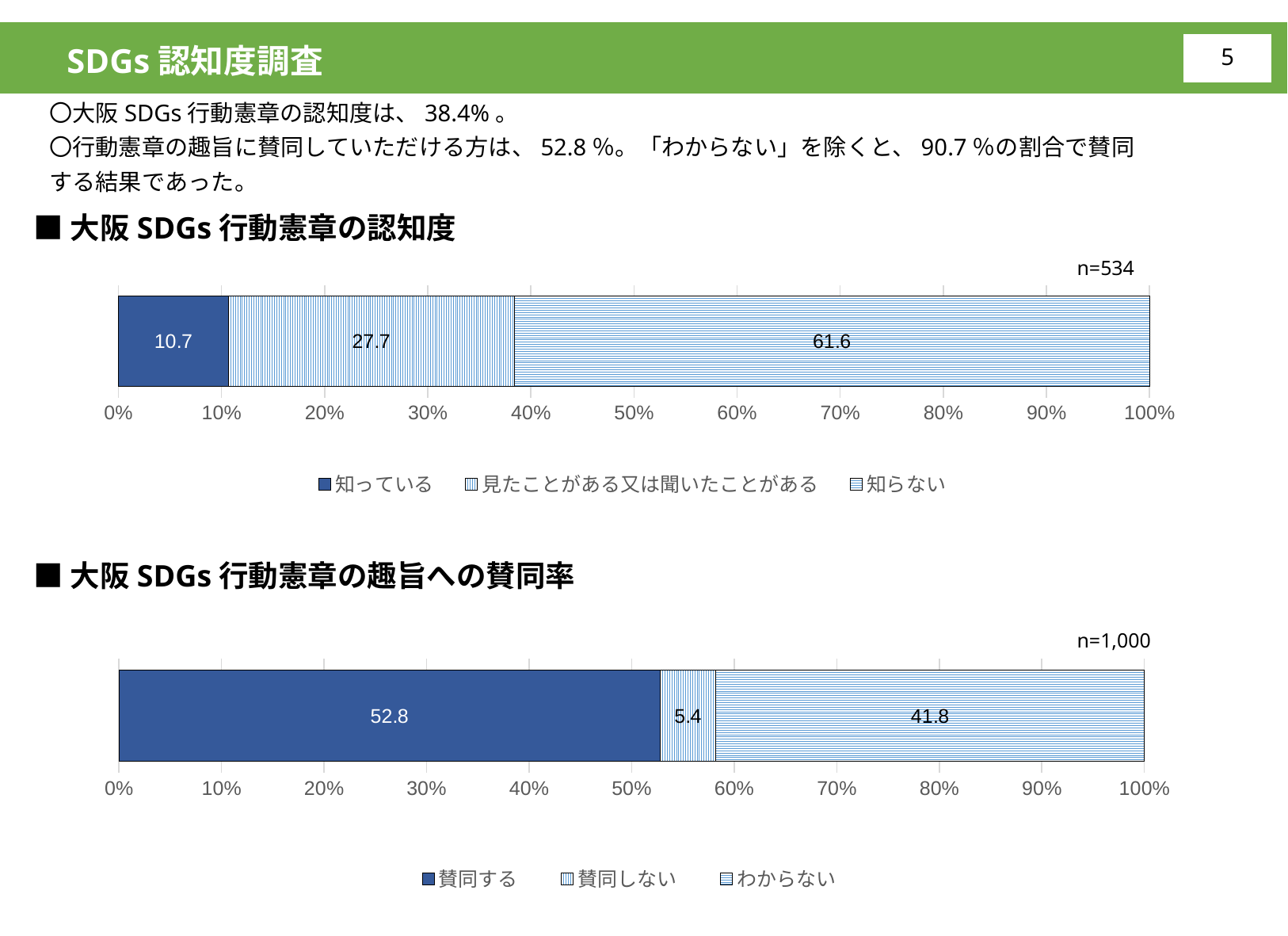
In the 大阪SDGs行動憲章の認知度 chart, what is the value for 知っている? 10.7 In the 大阪SDGs行動憲章の認知度 chart, what is the value for 知らない? 61.6 In the 大阪SDGs行動憲章の認知度 chart, which segment is the smallest? 知っている In the 大阪SDGs行動憲章の認知度 chart, how many series does the legend list? 3 What kind of chart is the 大阪SDGs行動憲章の趣旨への賛同率 chart? Stacked bar chart In the 大阪SDGs行動憲章の趣旨への賛同率 chart, what is the difference between 賛同する and わからない? 11.0 In the 大阪SDGs行動憲章の趣旨への賛同率 chart, what is the value for 賛同する? 52.8 In the 大阪SDGs行動憲章の趣旨への賛同率 chart, which is larger, 賛同する or わからない? 賛同する In the 大阪SDGs行動憲章の趣旨への賛同率 chart, what is the value for 賛同しない? 5.4 In the 大阪SDGs行動憲章の認知度 chart, which segment is the largest? 知らない What is the sample size (n) shown for the 大阪SDGs行動憲章の趣旨への賛同率 chart? n=1,000 In the 大阪SDGs行動憲章の認知度 chart, what is the difference between 知らない and 見たことがある又は聞いたことがある? 33.9